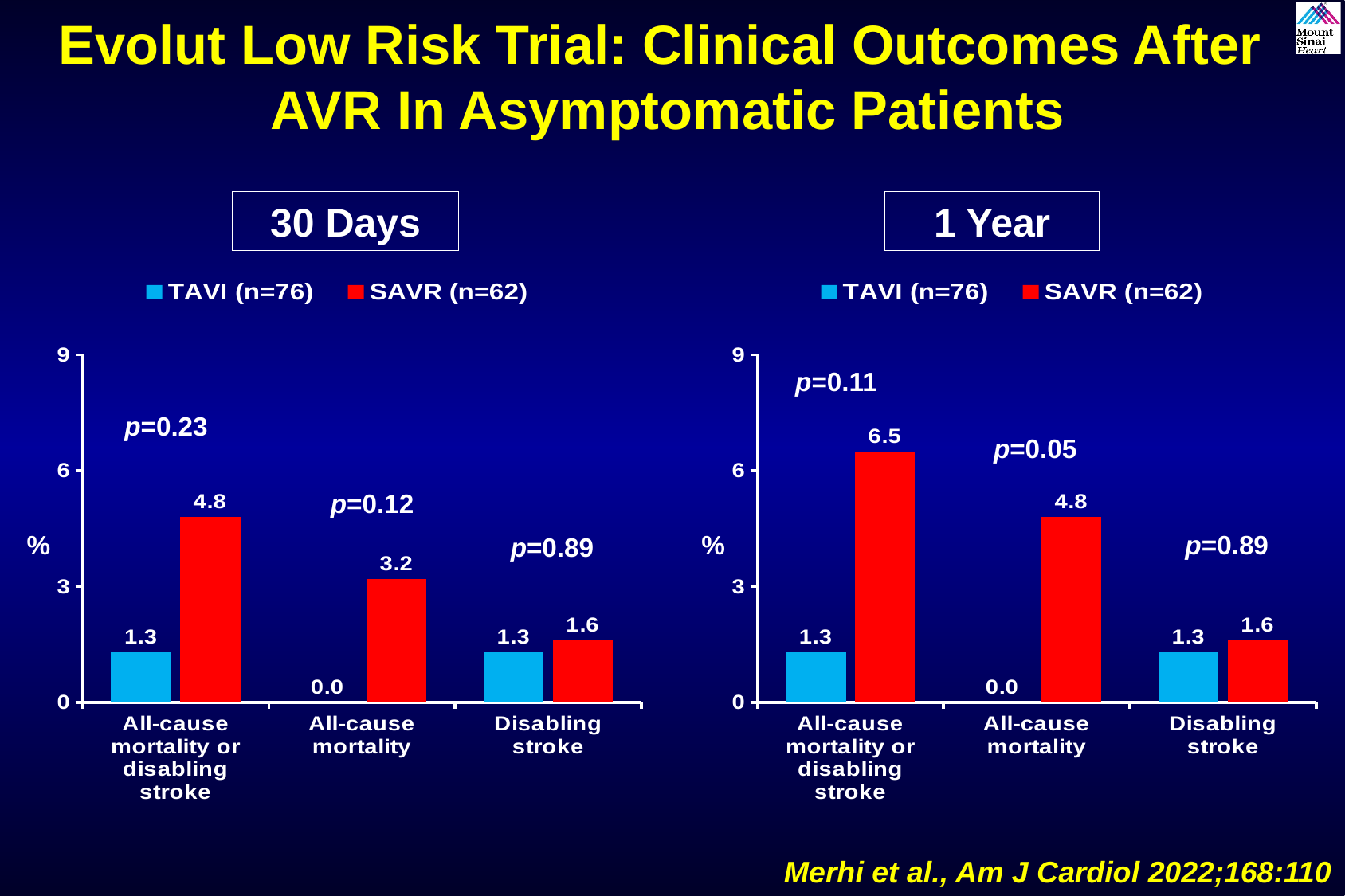
In the 1 Year chart, what is the SAVR value for disabling stroke? 1.6 In the 30 Days chart, what is the TAVI value for all-cause mortality? 0.0 How many series does the legend of the 30 Days chart list? 2 In the 30 Days chart, what is the SAVR value for all-cause mortality or disabling stroke? 4.8 In the 30 Days chart, which category has the lowest TAVI value? All-cause mortality In the 1 Year chart, which category has the highest SAVR value? All-cause mortality or disabling stroke How many categories are shown on the x axis of the 1 Year chart? 3 In the 30 Days chart, what is the difference between the SAVR and TAVI values for all-cause mortality? 3.2 In the 1 Year chart, what is the SAVR value for all-cause mortality or disabling stroke? 6.5 In the 30 Days chart, which is larger for disabling stroke, the TAVI value or the SAVR value? SAVR What kind of chart is the 1 Year chart? Bar chart In the 1 Year chart, what is the difference between the SAVR and TAVI values for all-cause mortality or disabling stroke? 5.2